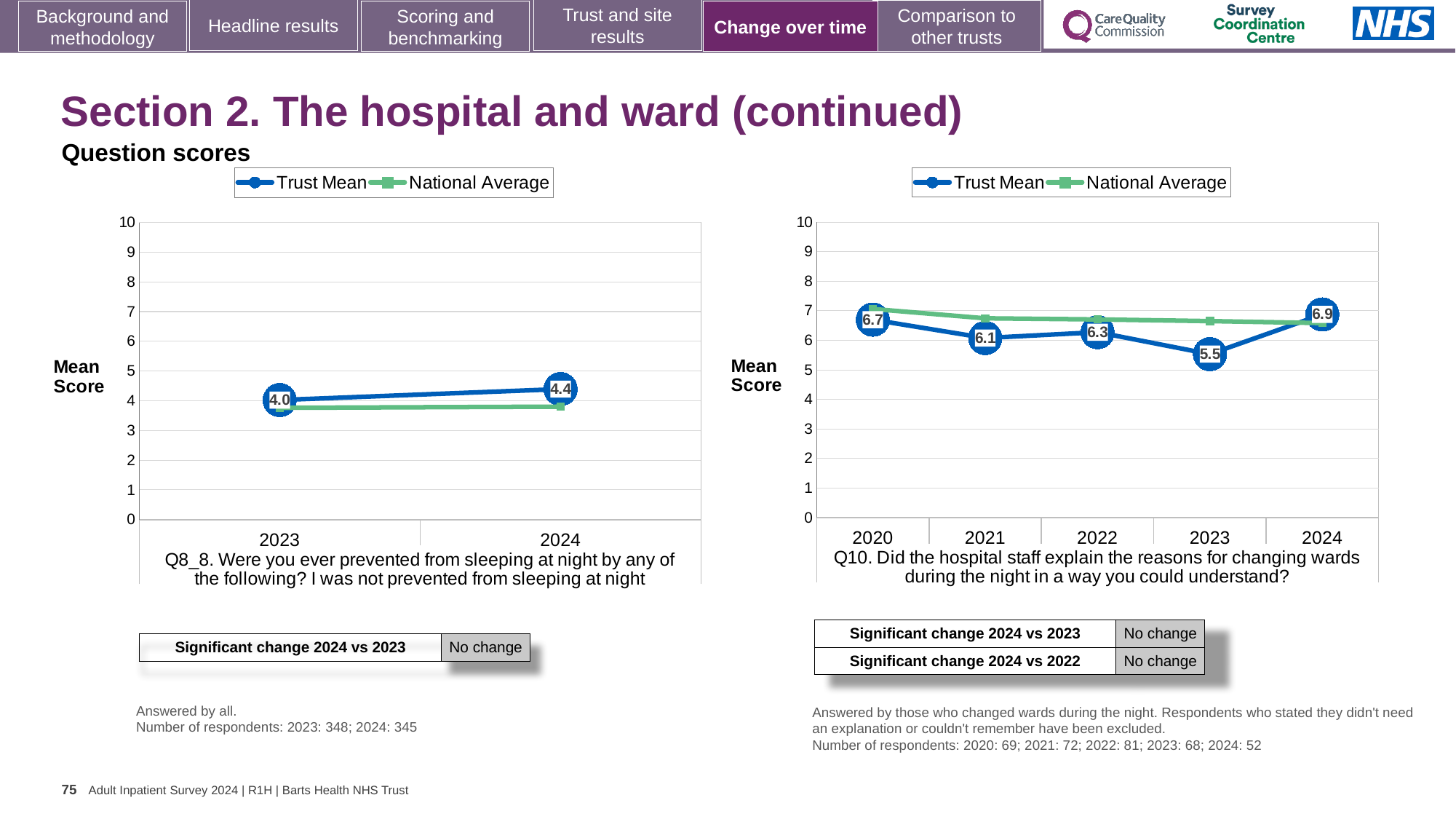
What type of chart is the left chart (Q8_8)? Line chart In the right chart (Q10), what is the Trust Mean score for 2023? 5.5 In the right chart (Q10), is the Trust Mean higher in 2020 or in 2021? 2020 How many series does the legend of the right chart (Q10) list? 2 In the left chart (Q8_8), is the National Average for 2024 greater or less than 5? less In the right chart (Q10), what is the difference between the Trust Mean in 2024 and in 2023? 1.4 In the right chart (Q10), which year has the highest Trust Mean score? 2024 In the left chart (Q8_8), by how much did the Trust Mean change from 2023 to 2024? 0.4 In the right chart (Q10), how many years are shown on the x axis? 5 In the left chart (Q8_8), what is the Trust Mean score for 2023? 4.0 In the left chart (Q8_8), what is the Trust Mean score for 2024? 4.4 In the right chart (Q10), which year has the lowest Trust Mean score? 2023